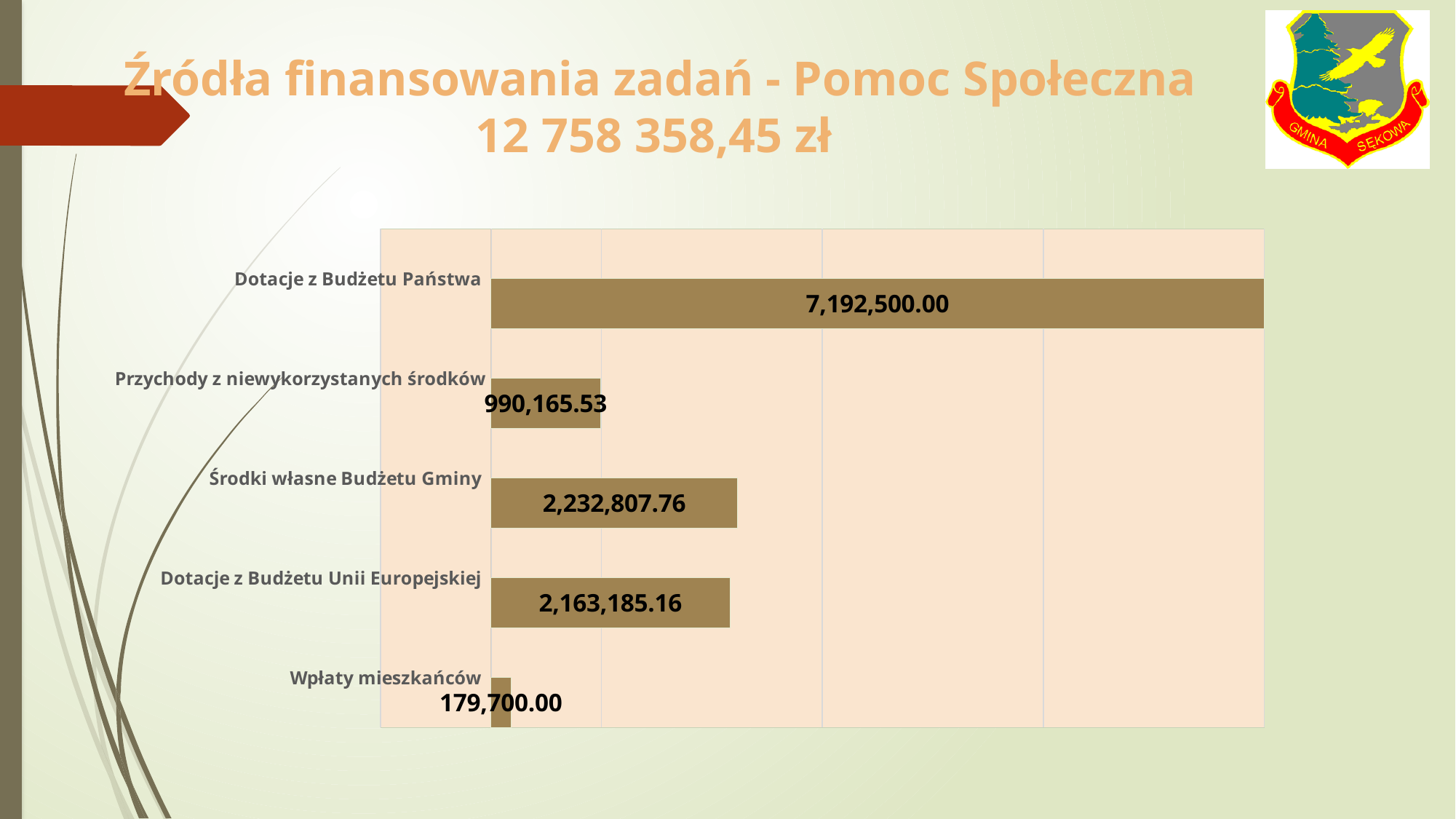
Which category has the highest value? Dotacje z Budżetu Państwa Which is larger, Dotacje z Budżetu Państwa or Środki własne Budżetu Gminy? Dotacje z Budżetu Państwa What is the difference between Dotacje z Budżetu Państwa and Przychody z niewykorzystanych środków? 6,202,334.47 What is the value for Środki własne Budżetu Gminy? 2,232,807.76 What is the value for Przychody z niewykorzystanych środków? 990,165.53 What is the difference between Środki własne Budżetu Gminy and Dotacje z Budżetu Unii Europejskiej? 69,622.60 What is the value for Wpłaty mieszkańców? 179,700.00 What is the value for Dotacje z Budżetu Unii Europejskiej? 2,163,185.16 What is the value for Dotacje z Budżetu Państwa? 7,192,500.00 How many categories are shown in the chart? 5 Which category has the lowest value? Wpłaty mieszkańców What kind of chart is shown on the slide? Bar chart